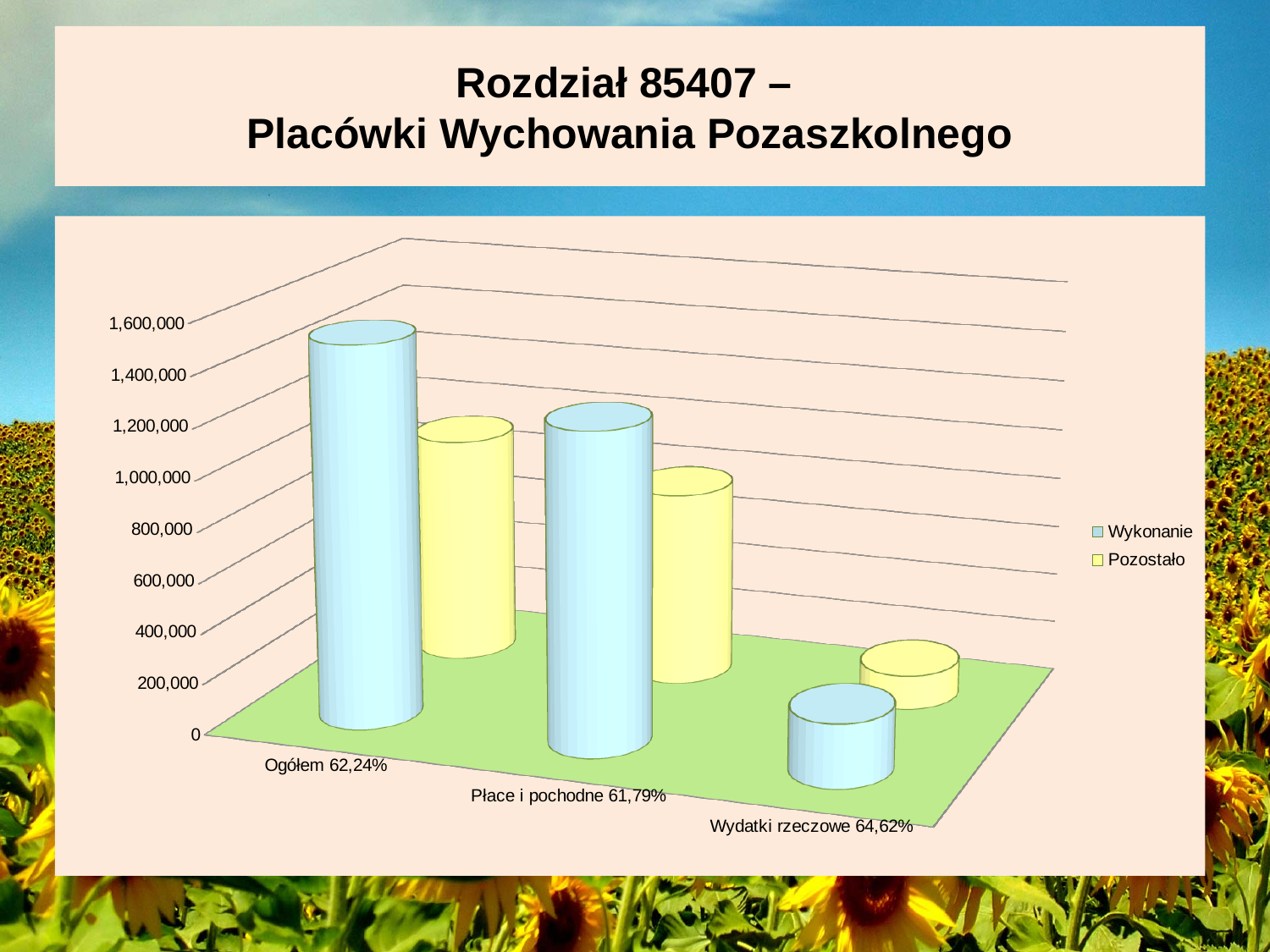
How many categories are shown on the x axis of the chart? 3 Which category has the highest Wykonanie value? Ogółem 62,24% Which category has the lowest Pozostało value? Wydatki rzeczowe 64,62% Which is larger: the Wykonanie value for Ogółem 62,24% or the Wykonanie value for Płace i pochodne 61,79%? Ogółem 62,24% Is the Wykonanie value for Ogółem 62,24% greater or less than 1,000,000? greater Which category has the lowest Wykonanie value? Wydatki rzeczowe 64,62% For Ogółem 62,24%, which is larger: Wykonanie or Pozostało? Wykonanie What kind of chart is shown on the slide? bar chart What are the two series named in the legend? Wykonanie and Pozostało How many series does the chart's legend list? 2 Is the Wykonanie value for Wydatki rzeczowe 64,62% greater or less than 600,000? less What is the title of the slide containing the chart? Rozdział 85407 – Placówki Wychowania Pozaszkolnego